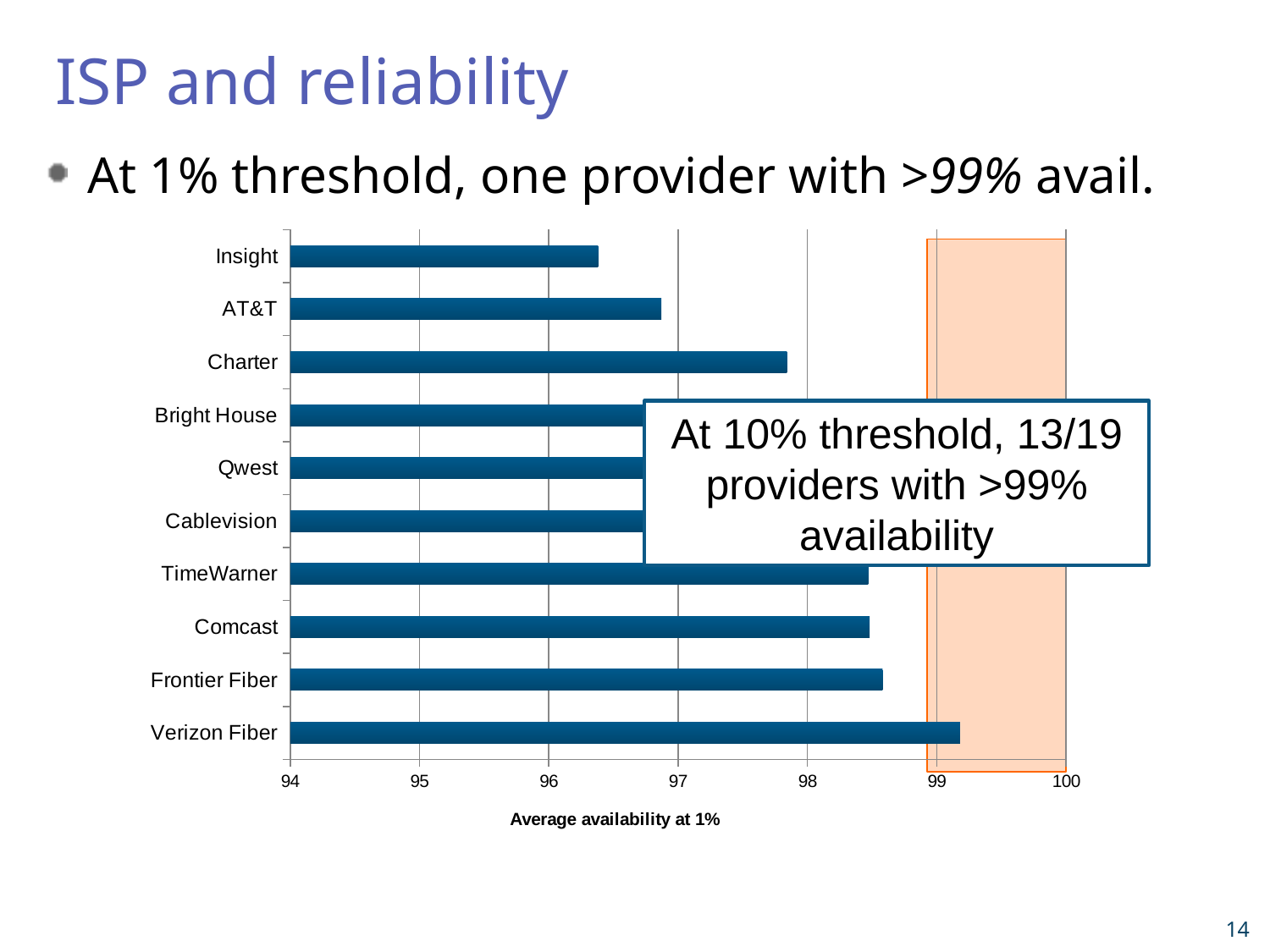
Is the value for Verizon Fiber greater or less than 99? greater Which ISP has the highest average availability at 1%? Verizon Fiber What kind of chart is shown on the slide? bar chart Is the value for Frontier Fiber greater or less than 98? greater Is the value for Insight greater or less than 97? less How many ISPs are listed on the chart? 10 Which has a higher average availability, Charter or AT&T? Charter Which has a higher average availability, Verizon Fiber or Frontier Fiber? Verizon Fiber What is the title of the horizontal axis? Average availability at 1% Which ISP has the lowest average availability at 1%? Insight